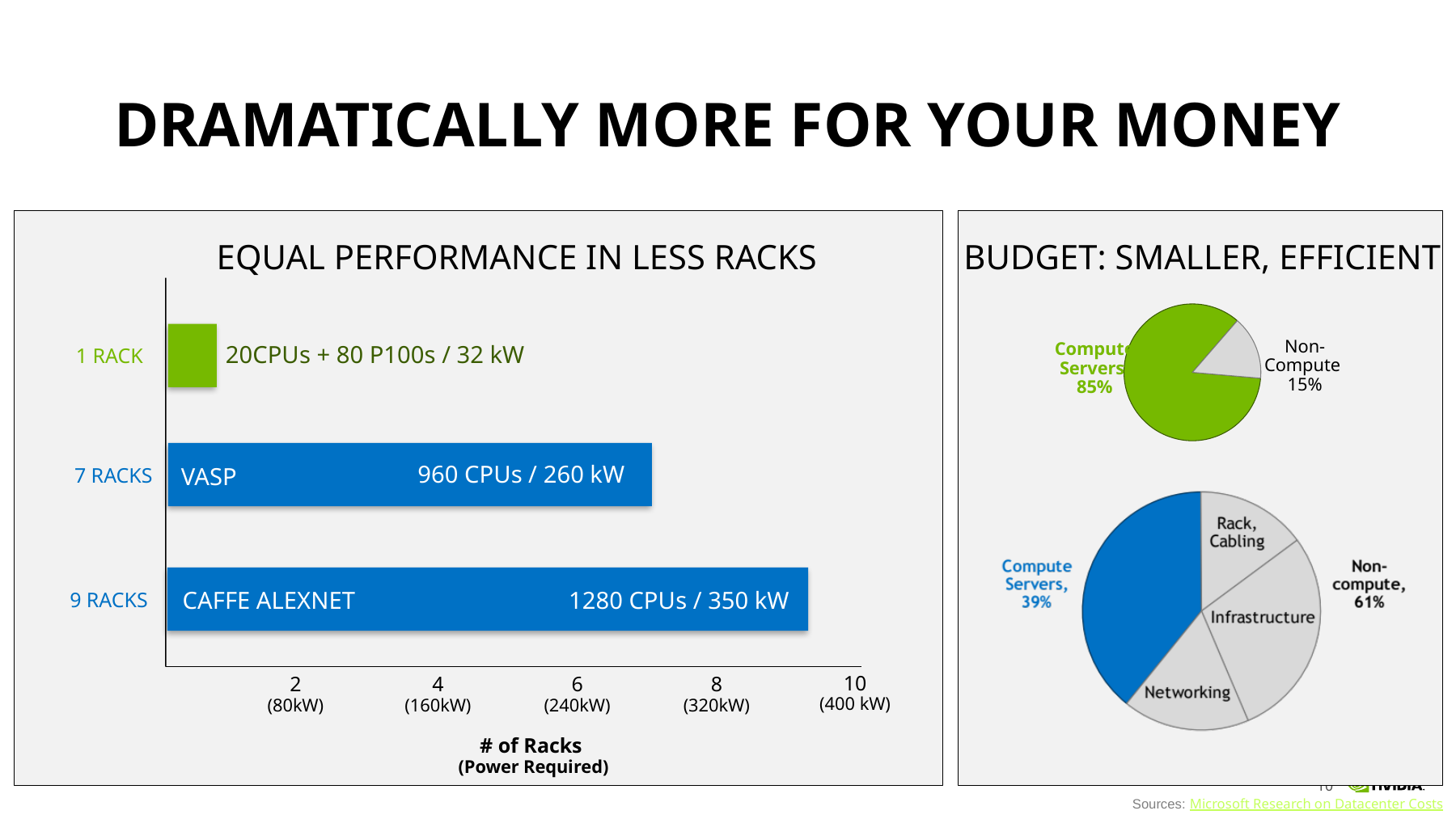
In the 'EQUAL PERFORMANCE IN LESS RACKS' chart, how many racks does the CAFFE ALEXNET bar represent? 9 RACKS In the 'EQUAL PERFORMANCE IN LESS RACKS' chart, what is the power required for the 1 RACK configuration? 32 kW In the bottom pie chart under 'BUDGET: SMALLER, EFFICIENT', which is larger, Compute Servers or Non-compute? Non-compute In the bottom pie chart under 'BUDGET: SMALLER, EFFICIENT', what share is Non-compute? 61% In the 'EQUAL PERFORMANCE IN LESS RACKS' chart, what kind of chart is shown? bar chart In the 'EQUAL PERFORMANCE IN LESS RACKS' chart, what is the label of the x axis? # of Racks (Power Required) In the top pie chart under 'BUDGET: SMALLER, EFFICIENT', what share is Compute Servers? 85% In the 'EQUAL PERFORMANCE IN LESS RACKS' chart, how many bars are plotted? 3 In the 'EQUAL PERFORMANCE IN LESS RACKS' chart, what is the difference in power required between CAFFE ALEXNET and VASP? 90 kW In the 'EQUAL PERFORMANCE IN LESS RACKS' chart, which configuration uses the most racks? CAFFE ALEXNET In the 'EQUAL PERFORMANCE IN LESS RACKS' chart, how many racks does the VASP bar represent? 7 RACKS In the 'EQUAL PERFORMANCE IN LESS RACKS' chart, how many CPUs does the CAFFE ALEXNET configuration use? 1280 CPUs